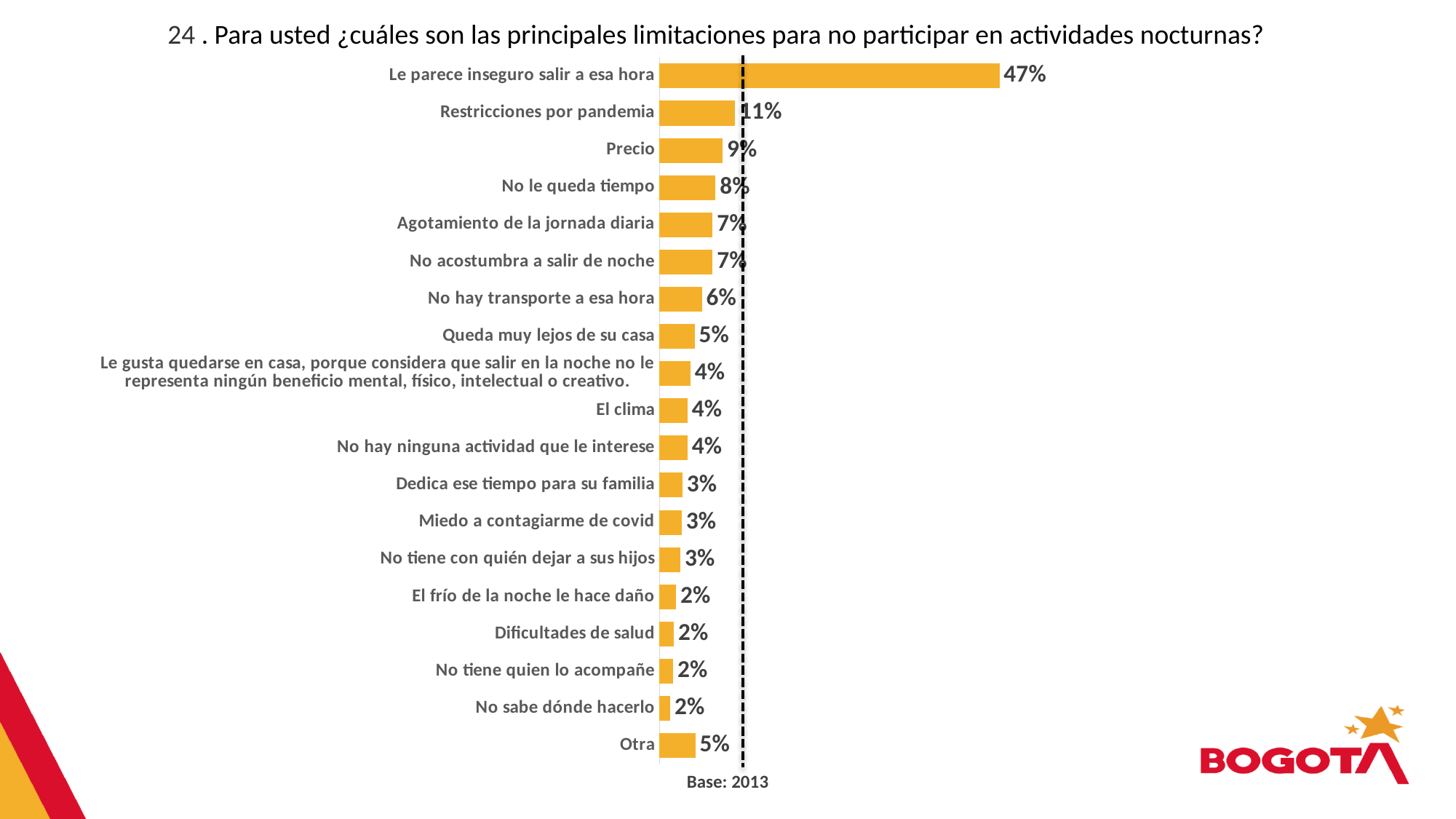
What is the value shown for 'Restricciones por pandemia'? 11% What is the base (number of respondents) shown below the chart? 2013 Which limitation has the highest percentage? Le parece inseguro salir a esa hora Which is larger, 'No hay transporte a esa hora' or 'El clima'? No hay transporte a esa hora What type of chart is shown on the slide? Bar chart What percentage of respondents said 'Le parece inseguro salir a esa hora'? 47% What is the difference in percentage points between 'Le parece inseguro salir a esa hora' and 'Restricciones por pandemia'? 36 How many categories (limitations) are shown in the chart? 19 What percentage is shown for 'No hay transporte a esa hora'? 6% Which is larger, 'Precio' or 'Queda muy lejos de su casa'? Precio What is the difference between 'Precio' and 'No le queda tiempo'? 1% What is the value for 'Otra'? 5%